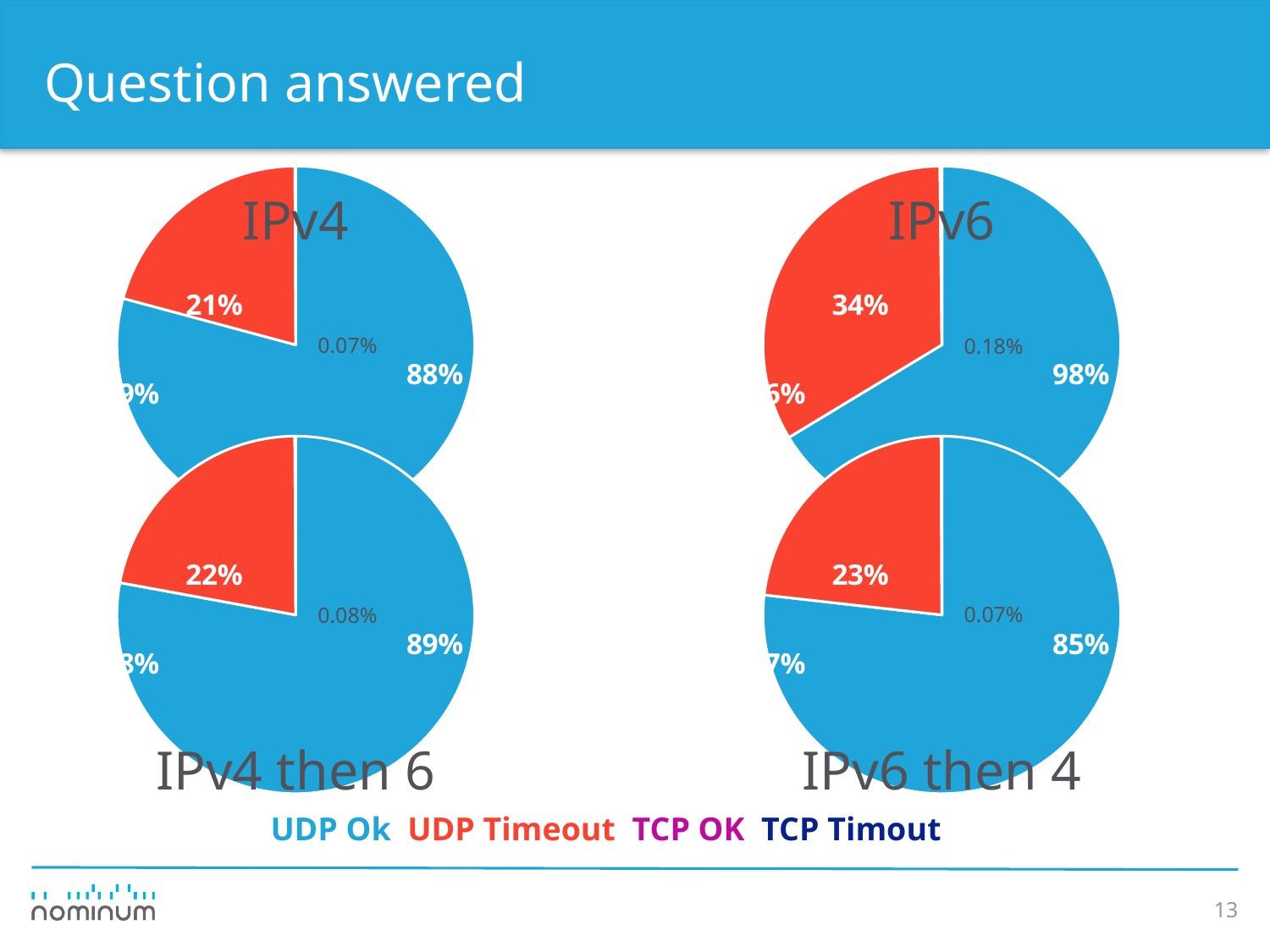
In the IPv6 pie chart, what is the small grey percentage label near the centre? 0.18% In the IPv6 then 4 pie chart, what percentage is labelled on the red (UDP Timeout) slice? 23% In the IPv6 pie chart, what percentage is labelled on the red (UDP Timeout) slice? 34% How many entries does the legend at the bottom of the slide list? 4 In the IPv6 pie chart, what percentage is labelled on the large blue (UDP Ok) slice? 98% What type of charts are shown on the slide? Pie charts Which pie chart has the largest red (UDP Timeout) slice: IPv4 or IPv6? IPv6 In the IPv4 pie chart, what percentage is labelled on the large blue (UDP Ok) slice? 88% How many pie charts are shown on the slide? 4 In the IPv4 pie chart, what percentage is labelled on the red (UDP Timeout) slice? 21% In the IPv4 then 6 pie chart, what percentage is labelled on the red (UDP Timeout) slice? 22% In the IPv6 then 4 pie chart, what percentage is labelled on the large blue (UDP Ok) slice? 85%